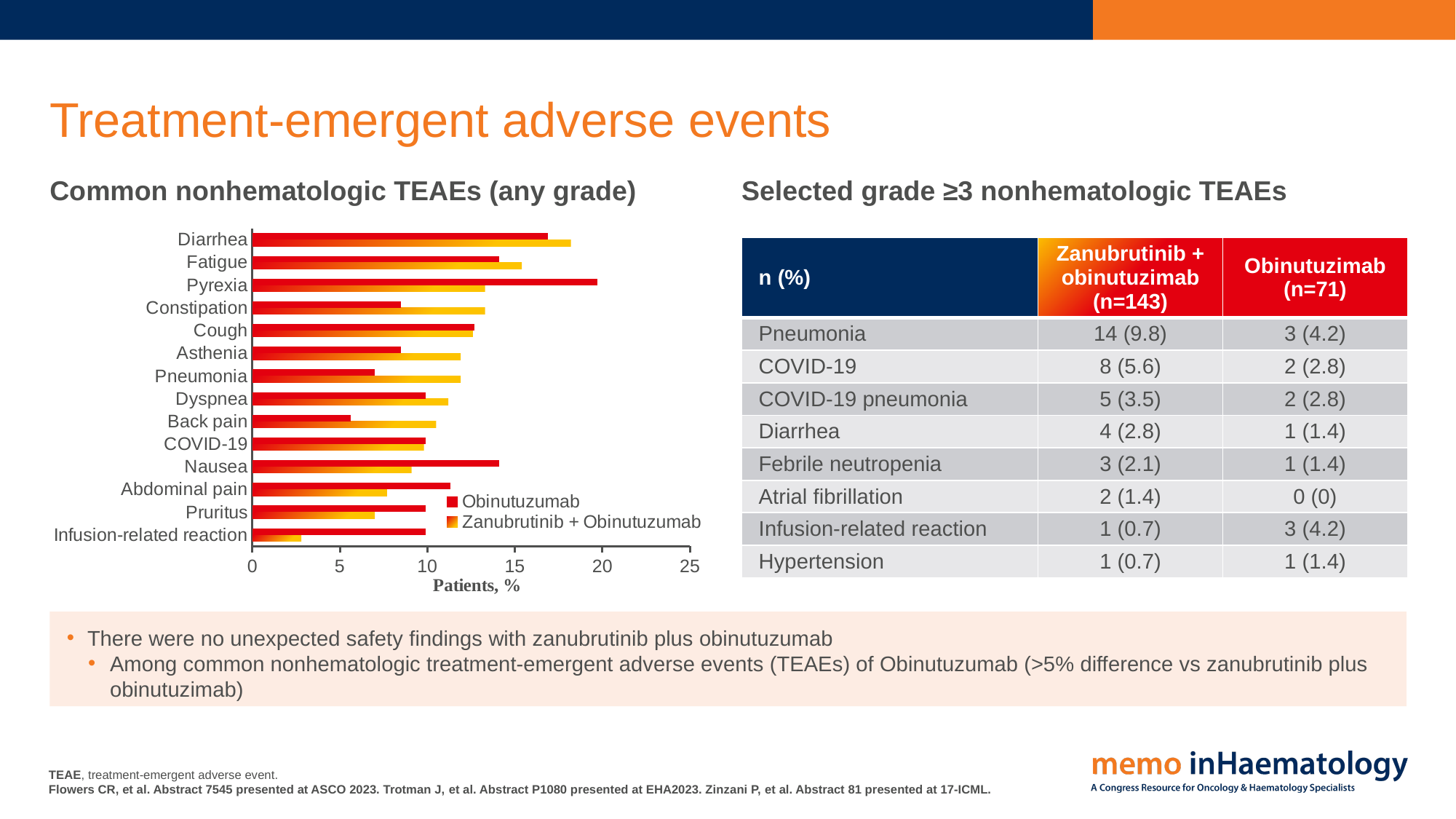
Which adverse event has the lowest Zanubrutinib + Obinutuzumab value in the bar chart? Infusion-related reaction For Pneumonia, which series has the larger value: Obinutuzumab or Zanubrutinib + Obinutuzumab? Zanubrutinib + Obinutuzumab Is the Zanubrutinib + Obinutuzumab value for Infusion-related reaction greater or less than 5? less How many adverse event categories are plotted in the bar chart? 14 Which adverse event has the highest Zanubrutinib + Obinutuzumab value in the bar chart? Diarrhea What is the label of the x axis of the bar chart? Patients, % Is the Obinutuzumab value for Back pain greater or less than 10? less Is the Obinutuzumab value for Pyrexia greater or less than 15? greater What kind of chart is shown under "Common nonhematologic TEAEs (any grade)"? bar chart How many series does the bar chart's legend list? 2 Which adverse event has the highest Obinutuzumab value in the bar chart? Pyrexia For Nausea, which series has the larger value: Obinutuzumab or Zanubrutinib + Obinutuzumab? Obinutuzumab